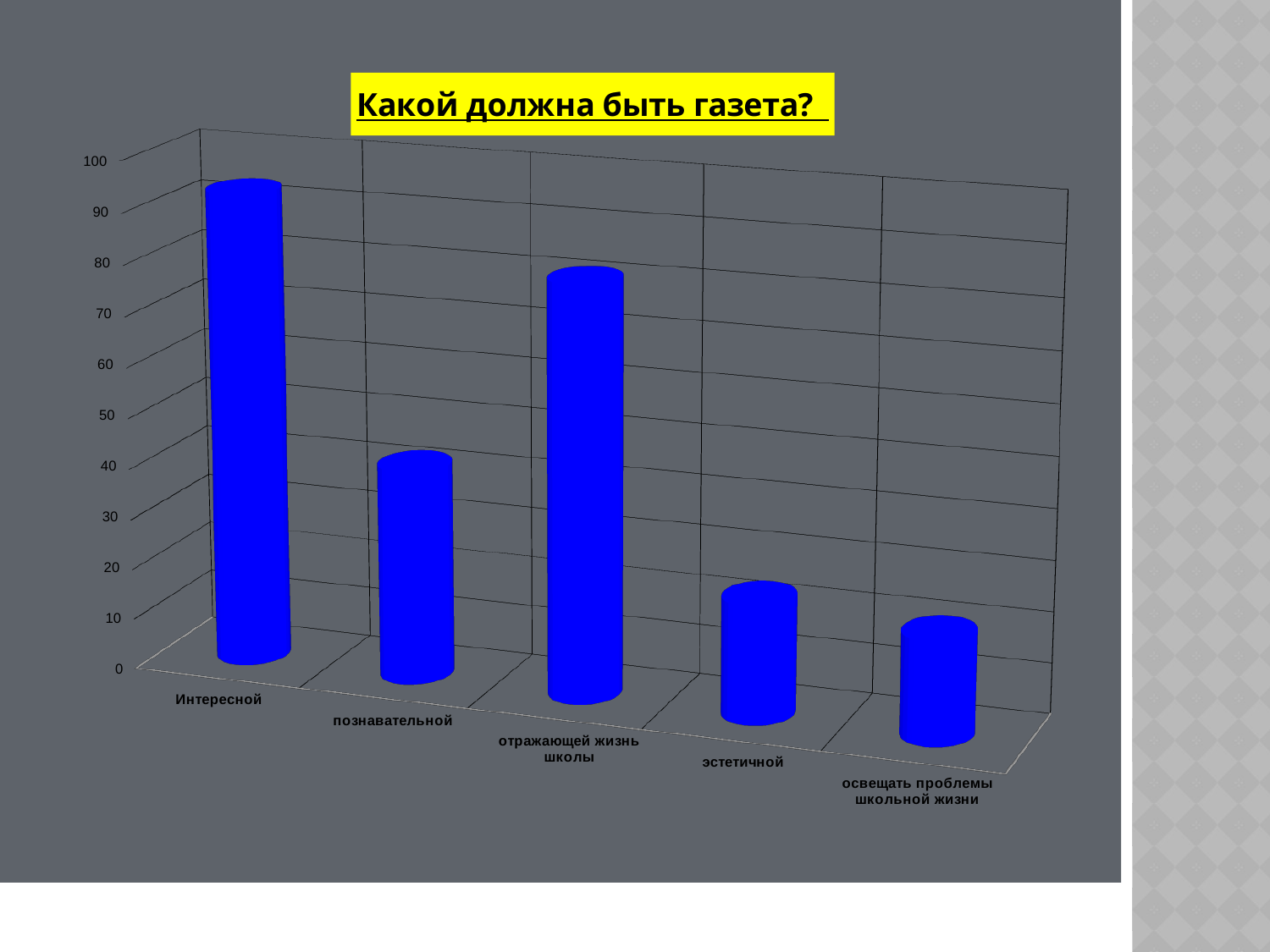
Which category has the highest value? Интересной Is the value for освещать проблемы школьной жизни greater or less than 30? less Which is larger, the value for Интересной or the value for познавательной? Интересной How many categories are shown on the x axis of the chart? 5 Which is larger, the value for отражающей жизнь школы or the value for эстетичной? отражающей жизнь школы Is the value for эстетичной greater or less than 40? less What colour are the bars in the chart? blue What kind of chart is shown on the slide? bar chart Is the value for познавательной greater or less than 60? less What is the title of the chart? Какой должна быть газета?